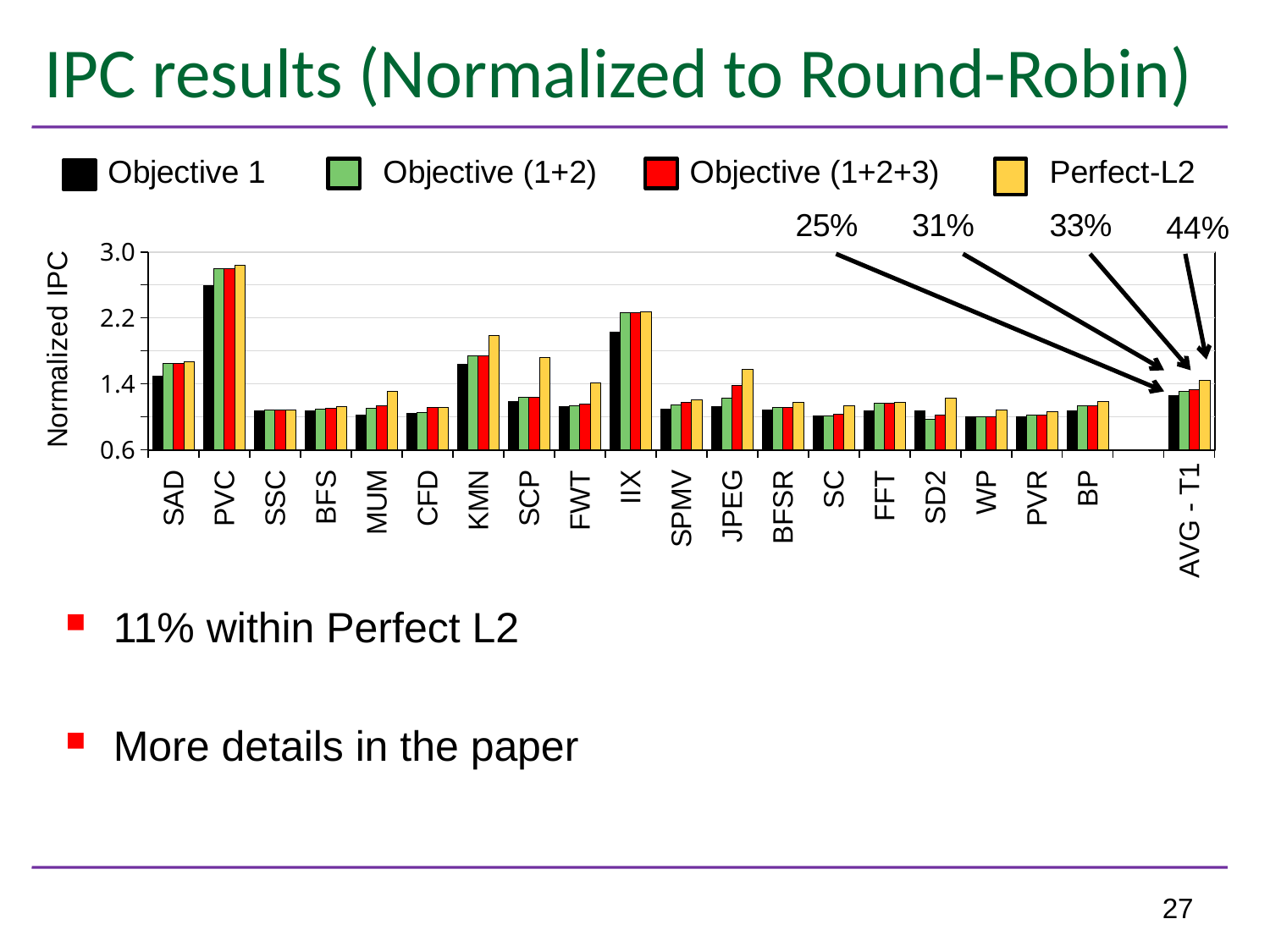
What percentage is annotated for the Objective 1 bar of AVG - T1? 25% Which has a larger Objective 1 value, PVC or SSC? PVC Is the Objective 1 value for PVC greater or less than 2.2? greater What kind of chart is shown on the slide? bar chart How many categories are shown along the x axis? 20 Is the Perfect-L2 value for SSC greater or less than 1.4? less Is the Perfect-L2 value for IIX greater or less than 2.2? greater Which has a larger Perfect-L2 value, KMN or CFD? KMN How many series does the legend list? 4 What percentage is annotated for the Perfect-L2 bar of AVG - T1? 44% What is the label of the y axis? Normalized IPC Which category has the highest Normalized IPC values? PVC